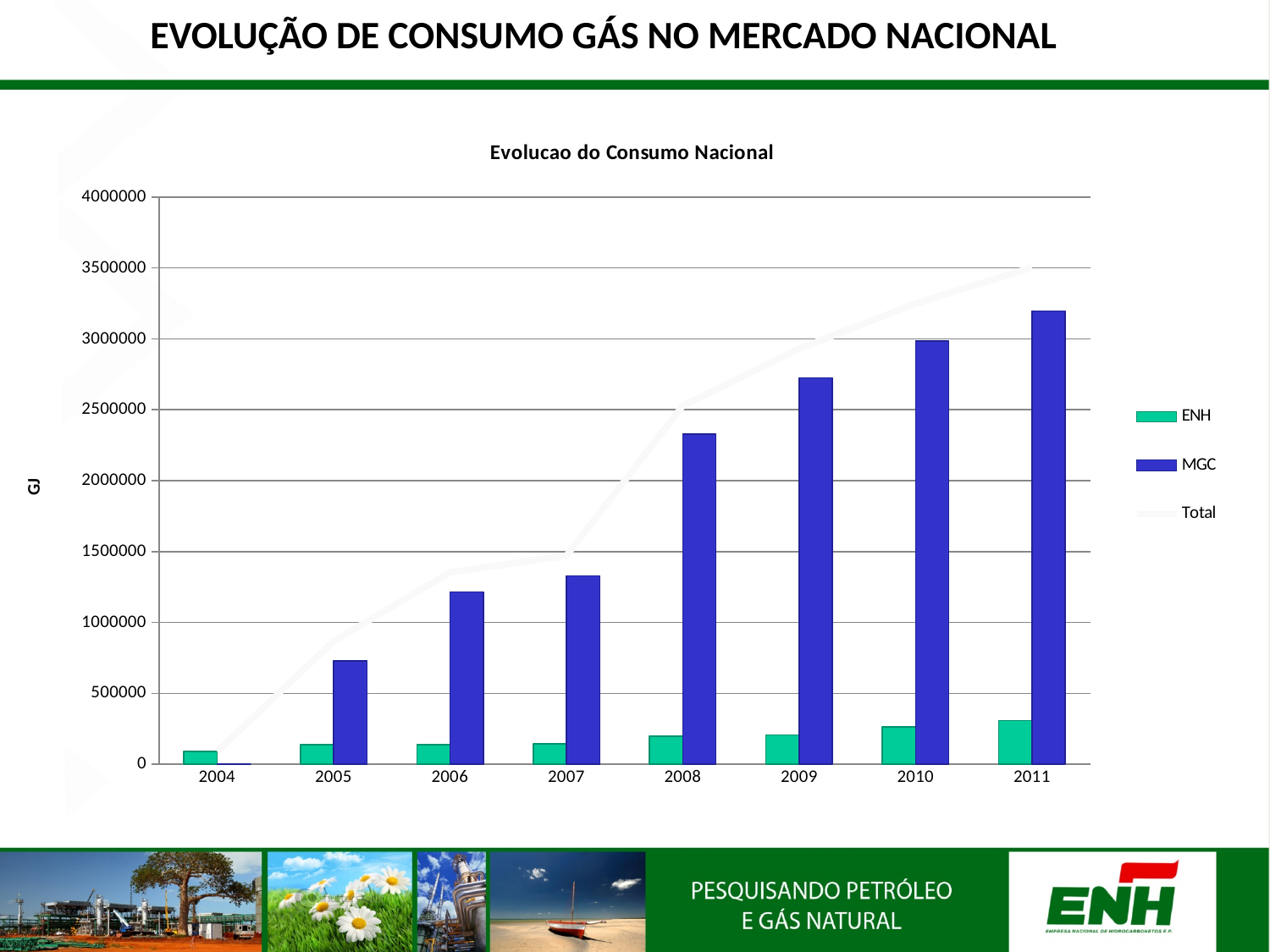
Is the ENH value for 2011 greater or less than 500000? less What is the label on the y axis of the chart? GJ How many years are shown on the x axis of the chart? 8 In which year is the ENH bar highest? 2011 In which year is the MGC bar highest? 2011 How many series does the chart legend list? 3 Do the MGC values generally rise or fall from 2004 to 2011? rise Which is larger, the MGC value for 2009 or the MGC value for 2007? 2009 Is the MGC value for 2011 greater or less than 3000000? greater In which year is the MGC bar lowest? 2004 What kind of chart is shown on the slide? combination bar and line chart Is the MGC value for 2005 greater or less than 1000000? less